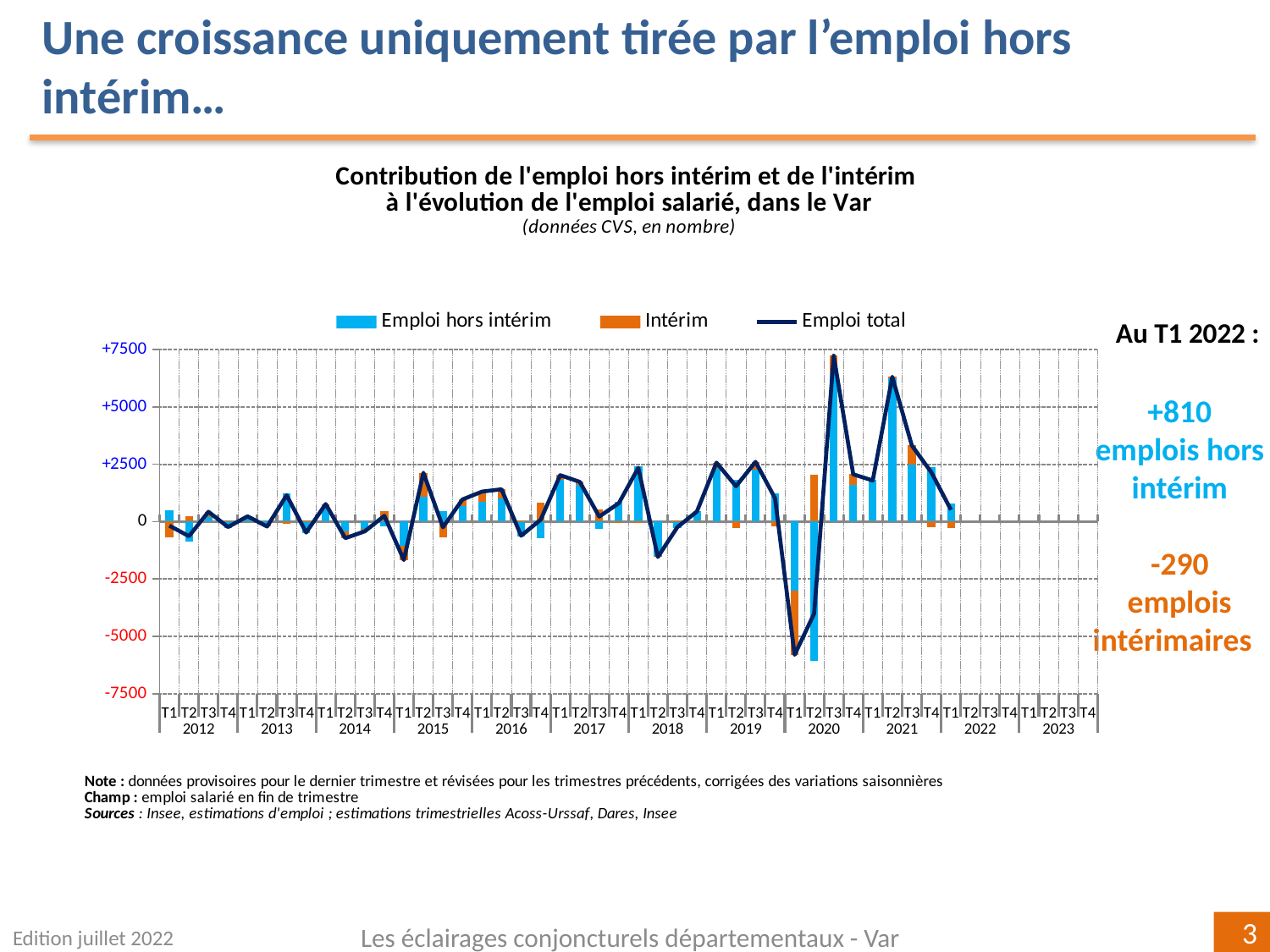
Is the value of Emploi hors intérim at T2 2020 greater or less than -5000? less What is the total of the stacked bar at T1 2022 (Emploi hors intérim plus Intérim)? +520 How many series does the chart legend list? 3 How many years are labelled on the x axis? 12 Which colour represents Intérim in the chart? Orange According to the annotation, what is the value for Emploi hors intérim at T1 2022? +810 According to the annotation, what is the value for Intérim at T1 2022? -290 Is the value of Emploi total at T3 2020 greater or less than +5000? greater In which quarter does the Emploi total line reach its lowest value? T1 2020 In which quarter does the Emploi total line reach its highest value? T3 2020 What kind of chart is shown on the slide? A combined bar and line chart Is the value of Emploi total at T1 2020 greater or less than -5000? less